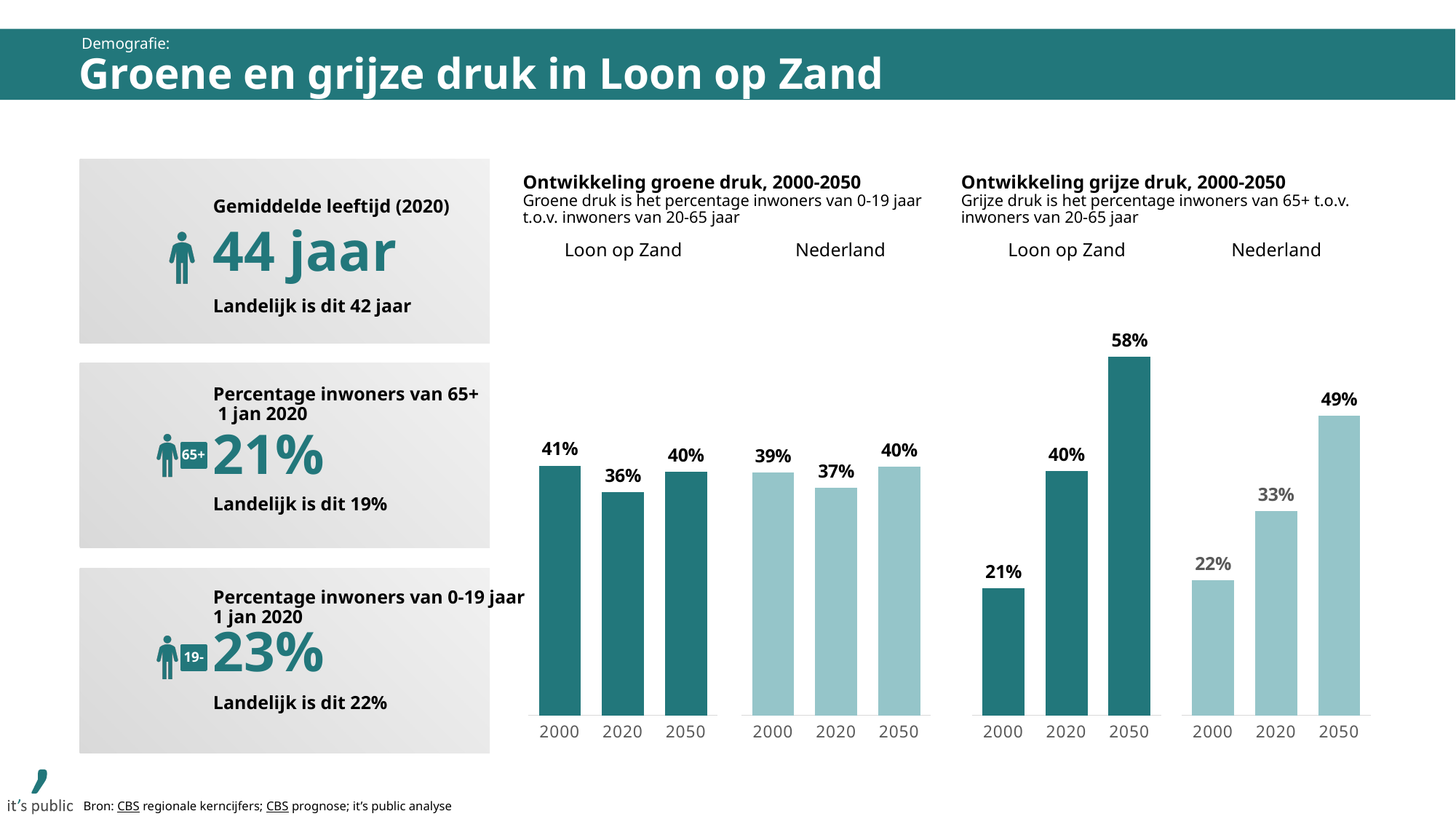
In the chart 'Ontwikkeling grijze druk, 2000-2050', how many bars are shown for Loon op Zand? 3 What kind of chart is 'Ontwikkeling groene druk, 2000-2050'? bar chart In the chart 'Ontwikkeling grijze druk, 2000-2050', which year has the highest value for Loon op Zand? 2050 In the chart 'Ontwikkeling groene druk, 2000-2050', what is the difference between the Loon op Zand value in 2000 and in 2020? 5% In the chart 'Ontwikkeling grijze druk, 2000-2050', what is the value for Nederland in 2000? 22% In the chart 'Ontwikkeling groene druk, 2000-2050', what is the value for Loon op Zand in 2000? 41% In the chart 'Ontwikkeling groene druk, 2000-2050', what is the value for Nederland in 2020? 37% In the chart 'Ontwikkeling groene druk, 2000-2050', which year has the lowest value for Loon op Zand? 2020 In the chart 'Ontwikkeling grijze druk, 2000-2050', what is the difference between the Loon op Zand value in 2050 and the Nederland value in 2050? 9% In the chart 'Ontwikkeling grijze druk, 2000-2050', which is larger: the Loon op Zand value in 2020 or the Nederland value in 2020? Loon op Zand In the chart 'Ontwikkeling grijze druk, 2000-2050', what is the value for Loon op Zand in 2050? 58% In the chart 'Ontwikkeling grijze druk, 2000-2050', do the values for Nederland rise or fall from 2000 to 2050? rise